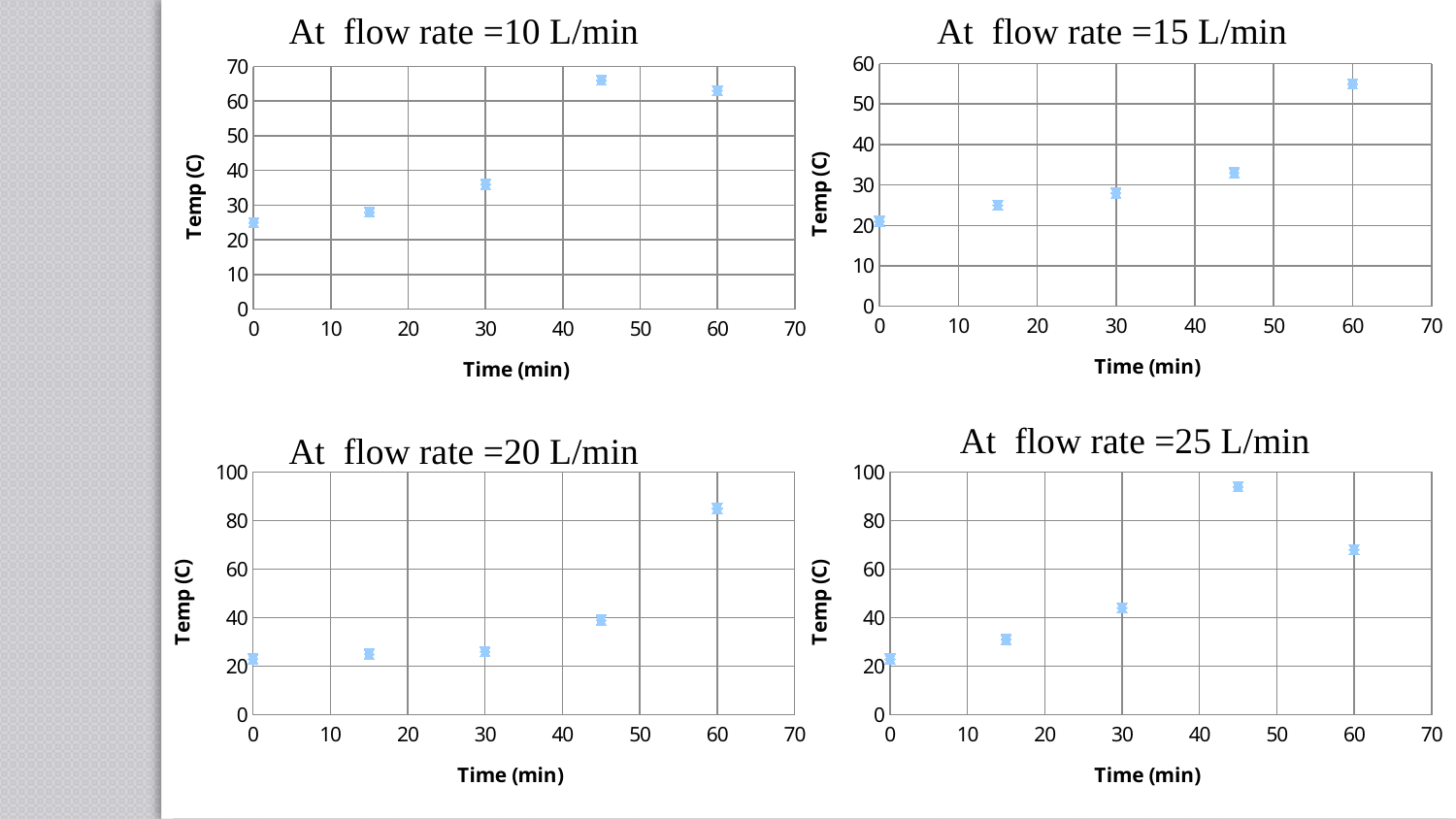
In the chart titled "At flow rate =20 L/min", is the temperature at 60 min greater or less than 80? greater In the chart titled "At flow rate =25 L/min", which is higher: the temperature at 45 min or at 60 min? 45 min In the chart titled "At flow rate =15 L/min", is the temperature at 0 min greater or less than 30? less In the chart titled "At flow rate =25 L/min", at which time (min) is the temperature highest? 45 What kind of chart is the one titled "At flow rate =15 L/min"? scatter chart In the chart titled "At flow rate =15 L/min", does the temperature rise or fall as time increases? rise In the chart titled "At flow rate =10 L/min", is the temperature at 45 min greater or less than 60? greater In the chart titled "At flow rate =10 L/min", at which time (min) is the temperature highest? 45 In the chart titled "At flow rate =15 L/min", at which time (min) is the temperature highest? 60 In the chart titled "At flow rate =20 L/min", at which time (min) is the temperature lowest? 0 How many data points are plotted in the chart titled "At flow rate =20 L/min"? 5